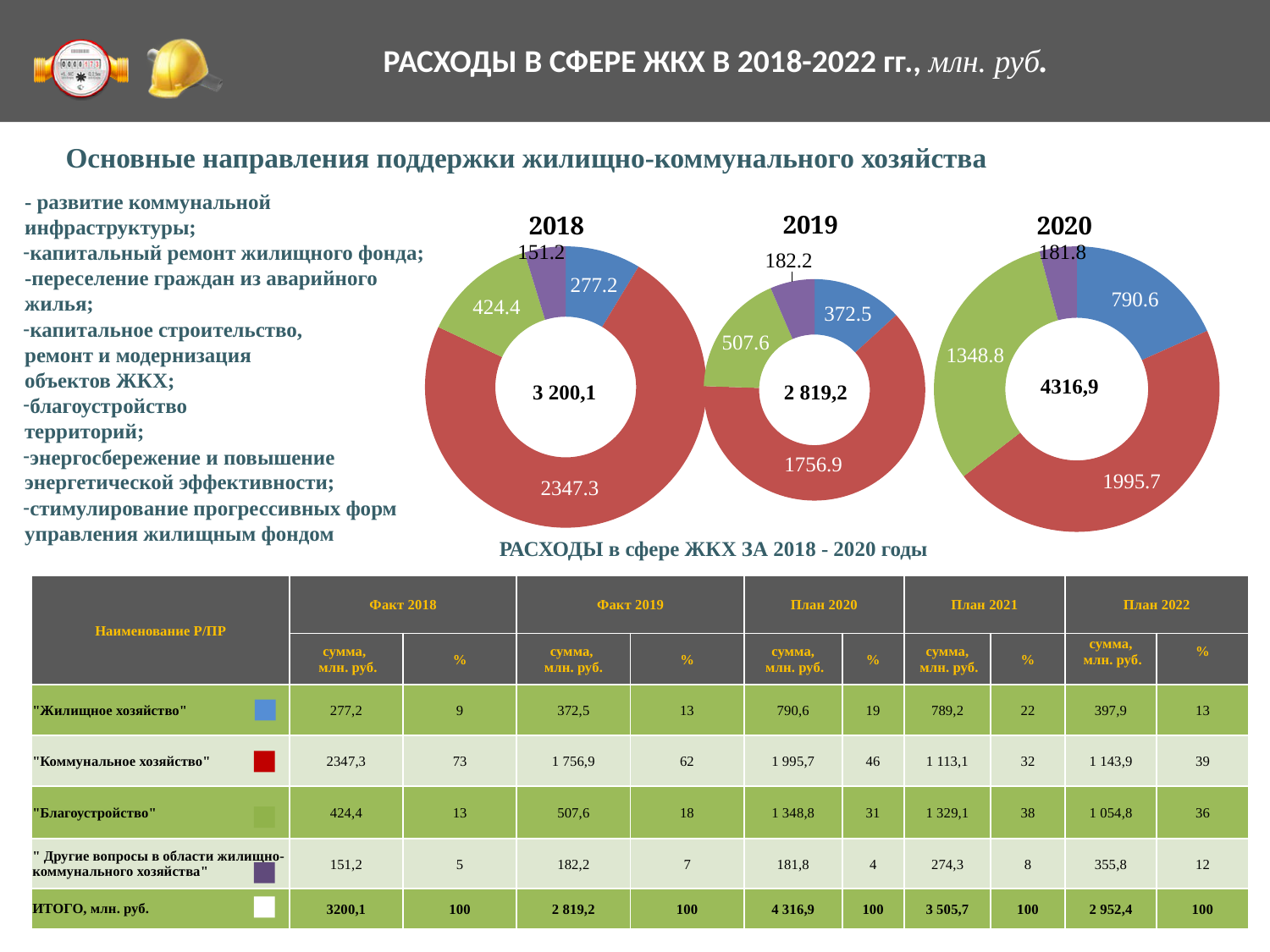
In the 2019 doughnut chart, what is the value of the blue segment? 372.5 In the 2018 doughnut chart, what is the value of the largest (red) segment? 2347.3 What kind of chart is used to show the 2018 expenses? Doughnut (pie) chart Which segment is the largest in the 2019 doughnut chart? 1756.9 (red, Коммунальное хозяйство) How many segments does each doughnut chart have? 4 In the 2020 doughnut chart, what is the value of the smallest (purple) segment? 181.8 What is the difference between the red segment values in the 2018 and 2019 doughnut charts? 590.4 What is the caption printed below the three doughnut charts? РАСХОДЫ в сфере ЖКХ ЗА 2018 - 2020 годы Which is larger: the blue segment in the 2020 chart or the blue segment in the 2019 chart? 2020 (790.6) What total is shown in the centre of the 2018 doughnut chart? 3 200,1 In the 2020 doughnut chart, what is the value of the green segment? 1348.8 What total is shown in the centre of the 2020 doughnut chart? 4316,9